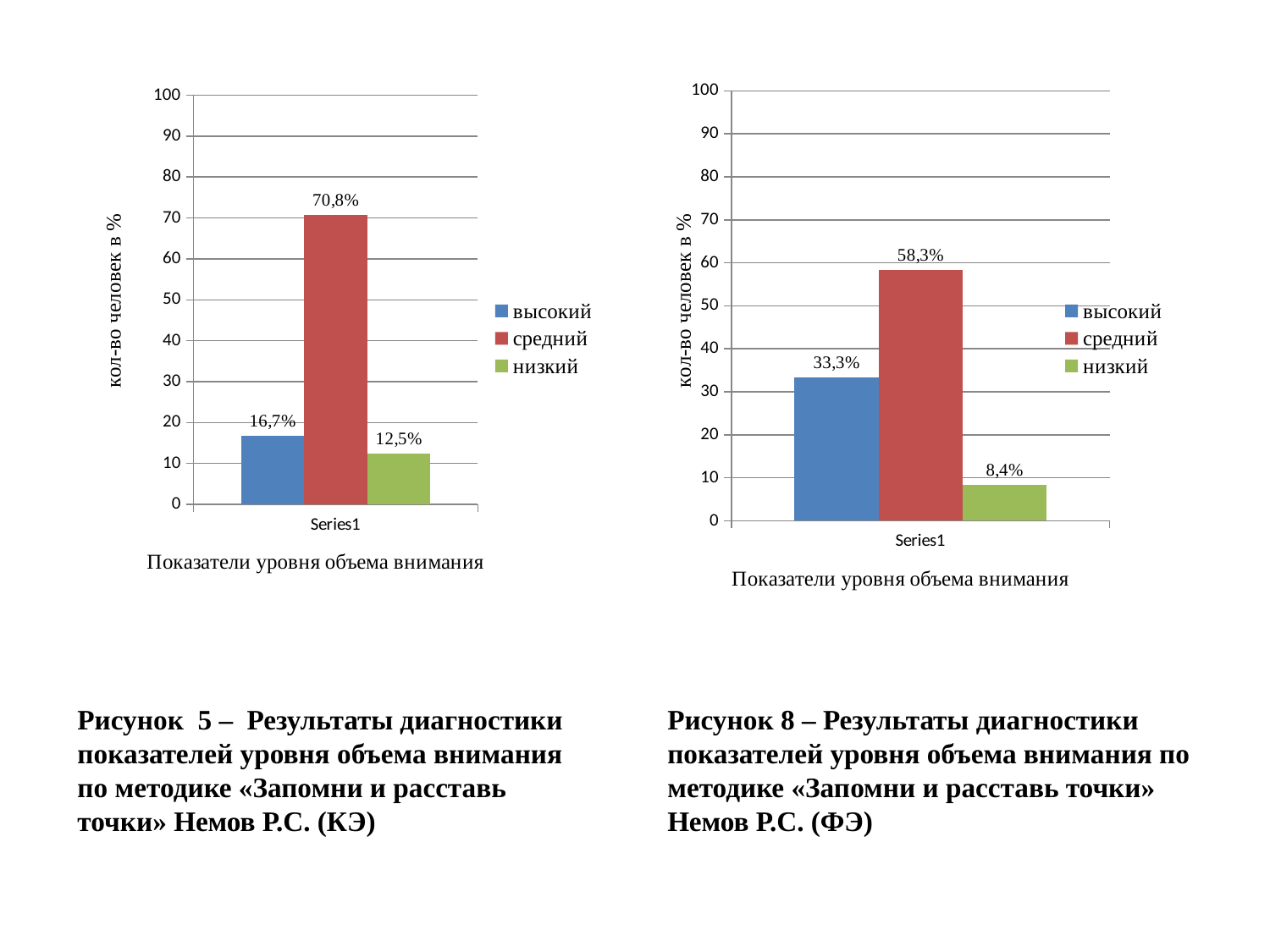
In the left chart (Рисунок 5, КЭ), which series has the lowest value? низкий In the right chart (Рисунок 8, ФЭ), what is the difference between the values for высокий and низкий? 24,9% What is the y-axis label of the right chart (Рисунок 8, ФЭ)? кол-во человек в % In the right chart (Рисунок 8, ФЭ), what is the value for низкий? 8,4% How many series does the legend of the right chart (Рисунок 8, ФЭ) list? 3 In the left chart (Рисунок 5, КЭ), is the value for высокий greater or less than 20? less In the left chart (Рисунок 5, КЭ), what is the value for средний? 70,8% In the left chart (Рисунок 5, КЭ), what is the difference between the values for средний and высокий? 54,1% In the right chart (Рисунок 8, ФЭ), which series has the highest value? средний In the right chart (Рисунок 8, ФЭ), what is the value for высокий? 33,3% What kind of chart is the left chart (Рисунок 5, КЭ)? bar chart Which is larger: the value for средний in the left chart (КЭ) or the value for средний in the right chart (ФЭ)? the left chart (КЭ)